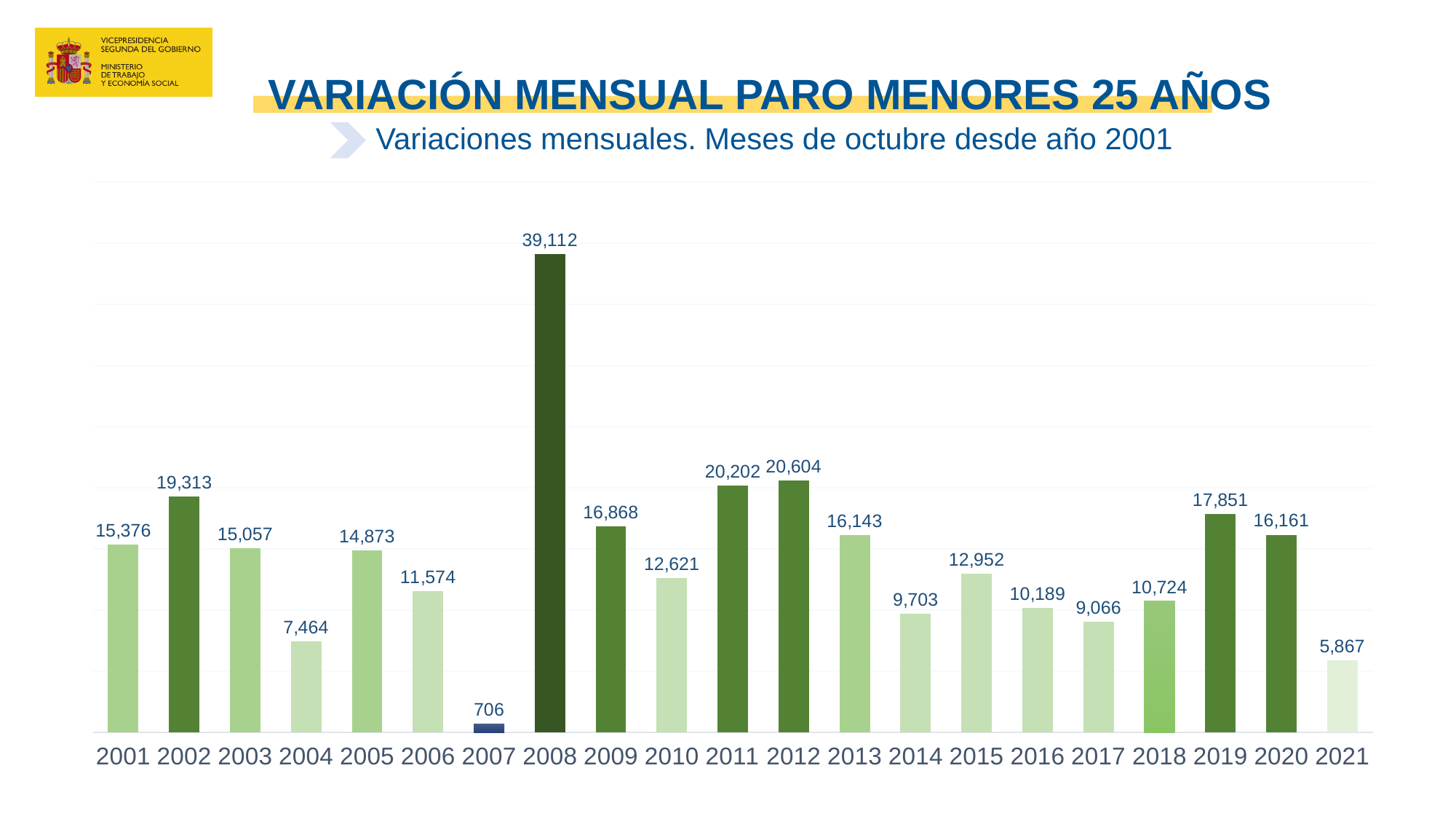
Which is larger, the value for 2014 or the value for 2015? 2015 Which year has the lowest value? 2007 What is the difference between the values for 2012 and 2011? 402 What is the title of the chart? VARIACIÓN MENSUAL PARO MENORES 25 AÑOS Which year has the highest value? 2008 What is the value for 2007? 706 What is the value for 2008? 39,112 What kind of chart is shown on the slide? Bar chart What is the value for 2021? 5,867 How many years are shown on the x axis? 21 What is the difference between the values for 2020 and 2021? 10,294 Which is larger, the value for 2002 or the value for 2019? 2002